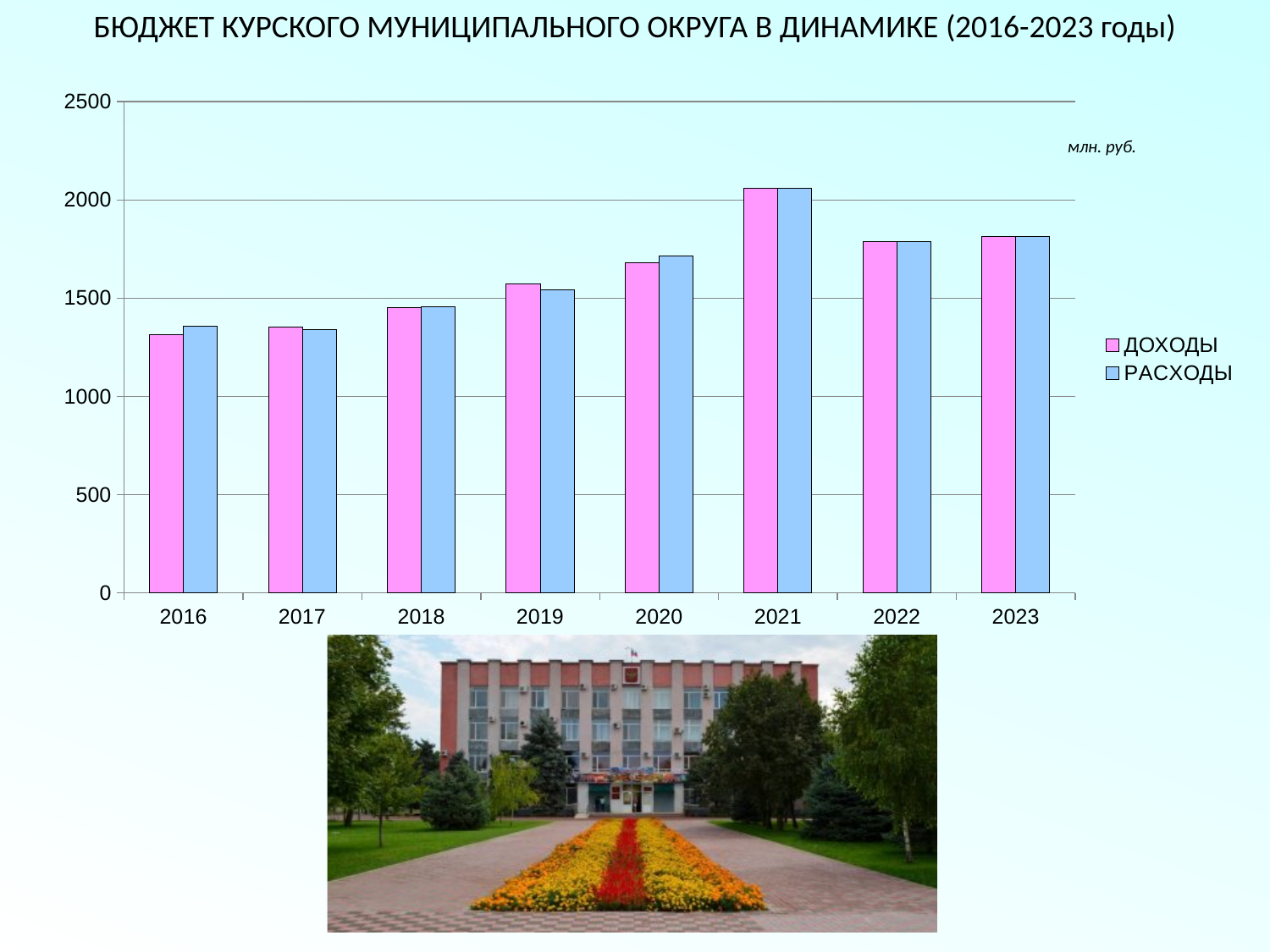
Is the value of РАСХОДЫ for 2020 greater or less than 1500? greater How many series does the legend list? 2 Which year has larger ДОХОДЫ: 2021 or 2022? 2021 What kind of chart is shown on the slide? bar chart Is the value of ДОХОДЫ for 2021 greater or less than 2000? greater How many years are shown on the x axis? 8 Is the value of РАСХОДЫ for 2023 greater or less than 2000? less In which year are РАСХОДЫ highest? 2021 In which year are ДОХОДЫ highest? 2021 What unit is indicated on the chart? млн. руб. Which is larger for 2016: ДОХОДЫ or РАСХОДЫ? РАСХОДЫ